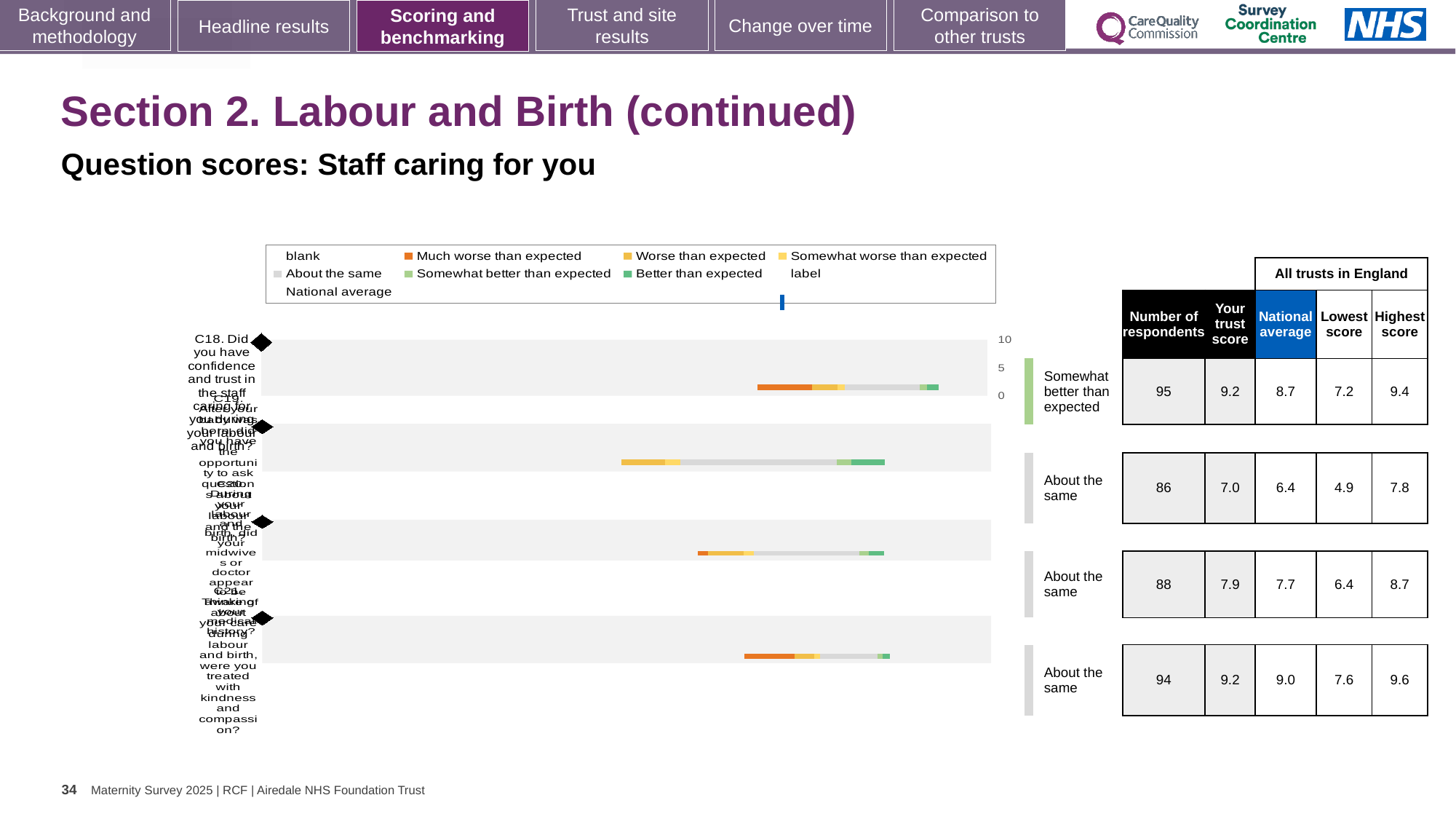
In the table next to the chart, is the trust score for the third row (C20) larger or smaller than its national average? larger Which legend entry is shown in orange in the chart? Much worse than expected How many bars (question rows) does the chart contain? 4 In the table next to the chart, what is the difference between the trust score and the national average for the first row (C18)? 0.5 How many entries does the chart's legend list? 9 What kind of chart is shown on the slide? bar chart Which legend entry is shown in light grey in the chart? About the same In the table next to the chart, what is the national average for the second row (C19)? 6.4 In the table next to the chart, what is the number of respondents for the third row (C20)? 88 In the table next to the chart, what is the highest score for the fourth row (C21)? 9.6 In the table next to the chart, which row has the lowest 'Your trust score'? About the same (C19), 7.0 In the table next to the chart, what is the trust score for the first row (C18, confidence and trust in staff)? 9.2